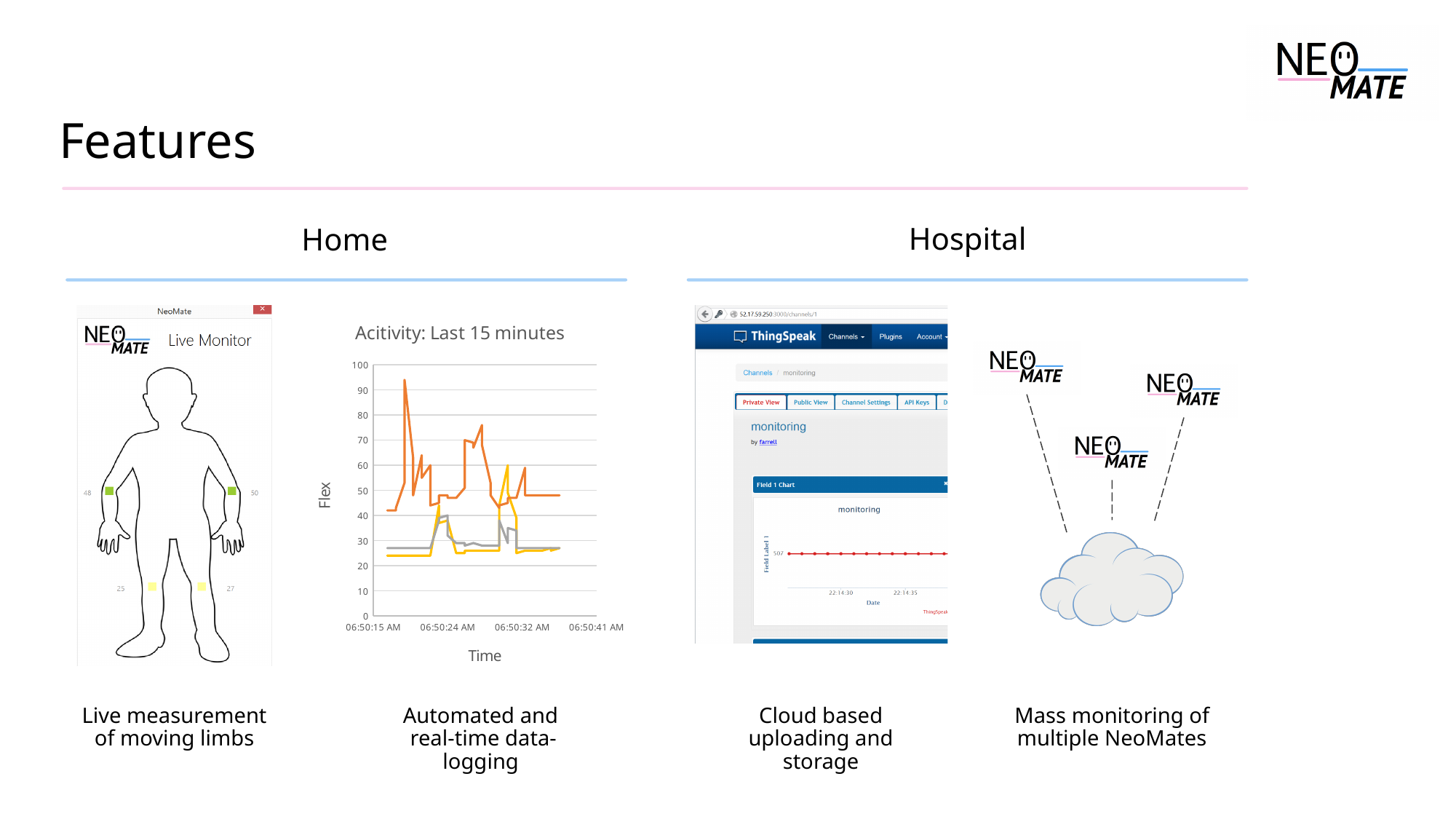
In the ThingSpeak 'monitoring' chart, do the values rise, fall or stay flat along the x axis? stay flat In the 'Acitivity: Last 15 minutes' chart, is the highest value of the gray line greater or less than 50? less In the 'Acitivity: Last 15 minutes' chart, what is the label of the y axis? Flex What kind of chart is the ThingSpeak 'monitoring' chart? line chart In the 'Acitivity: Last 15 minutes' chart, is the highest value of the orange line greater or less than 80? greater In the ThingSpeak 'monitoring' chart, what value does the red line sit at on the y axis? 507 What is the title of the chart in the Home section? Acitivity: Last 15 minutes In the 'Acitivity: Last 15 minutes' chart, how many lines are plotted? 4 In the 'Acitivity: Last 15 minutes' chart, is the highest value of the yellow line greater or less than 70? less What kind of chart is the 'Acitivity: Last 15 minutes' chart? line chart In the 'Acitivity: Last 15 minutes' chart, what is the first time shown on the x axis? 06:50:15 AM In the 'Acitivity: Last 15 minutes' chart, which line reaches the highest value: orange, yellow or gray? orange